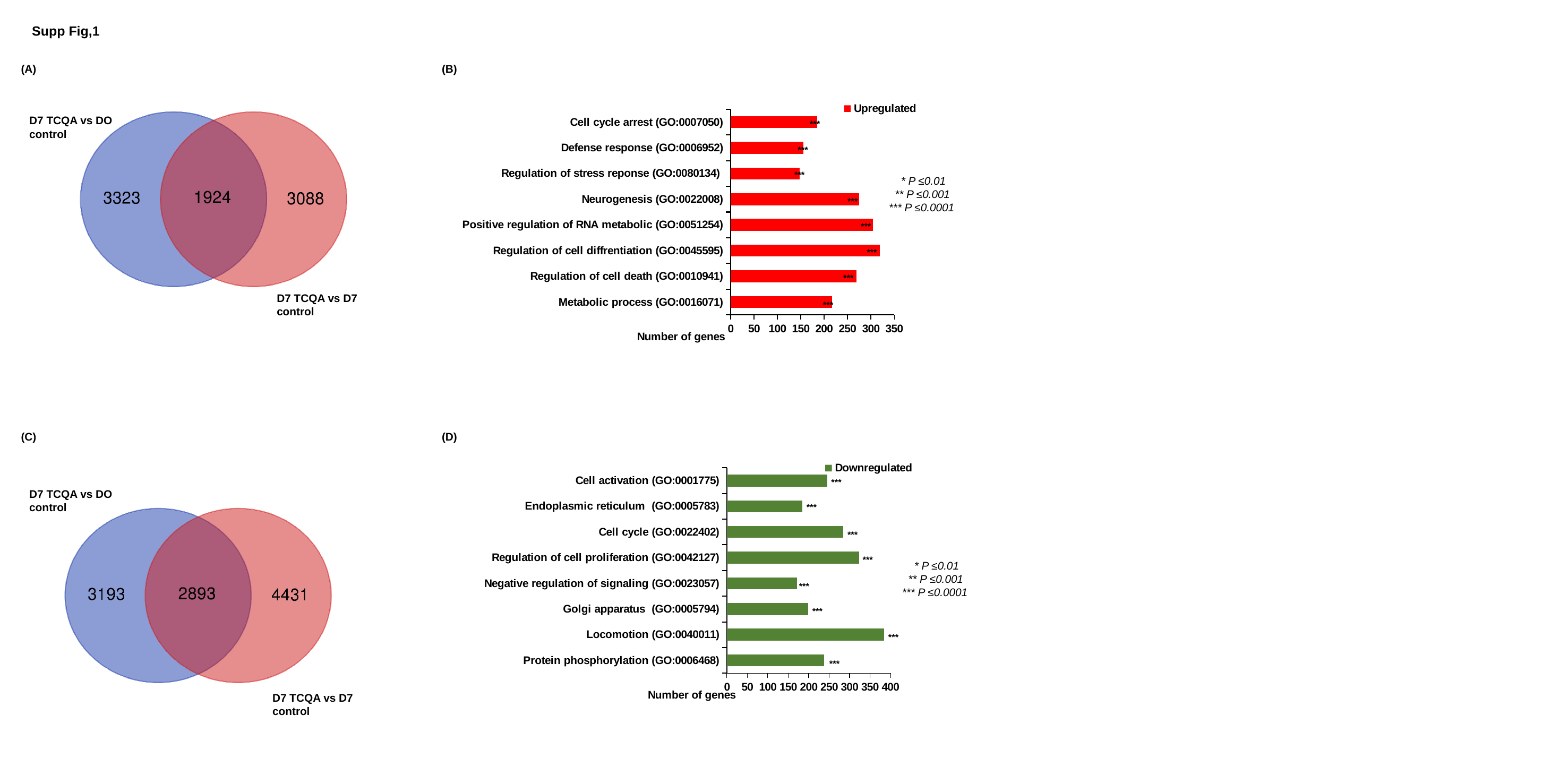
In chart (B), is the value for Defense response (GO:0006952) greater or less than 200? less In chart (D), is the value for Endoplasmic reticulum (GO:0005783) greater or less than 250? less What is the legend entry shown in chart (B)? Upregulated In chart (B), is the value for Cell cycle arrest (GO:0007050) greater or less than 150? greater How many categories are plotted in chart (B)? 8 In chart (D), which category has the highest number of genes? Locomotion (GO:0040011) How many series does the legend of chart (D) list? 1 In chart (B), which has more genes: Neurogenesis (GO:0022008) or Regulation of stress reponse (GO:0080134)? Neurogenesis (GO:0022008) What kind of chart is chart (D)? bar chart In chart (B), which category has the highest number of genes? Regulation of cell diffrentiation (GO:0045595) In chart (D), which has more genes: Regulation of cell proliferation (GO:0042127) or Golgi apparatus (GO:0005794)? Regulation of cell proliferation (GO:0042127)